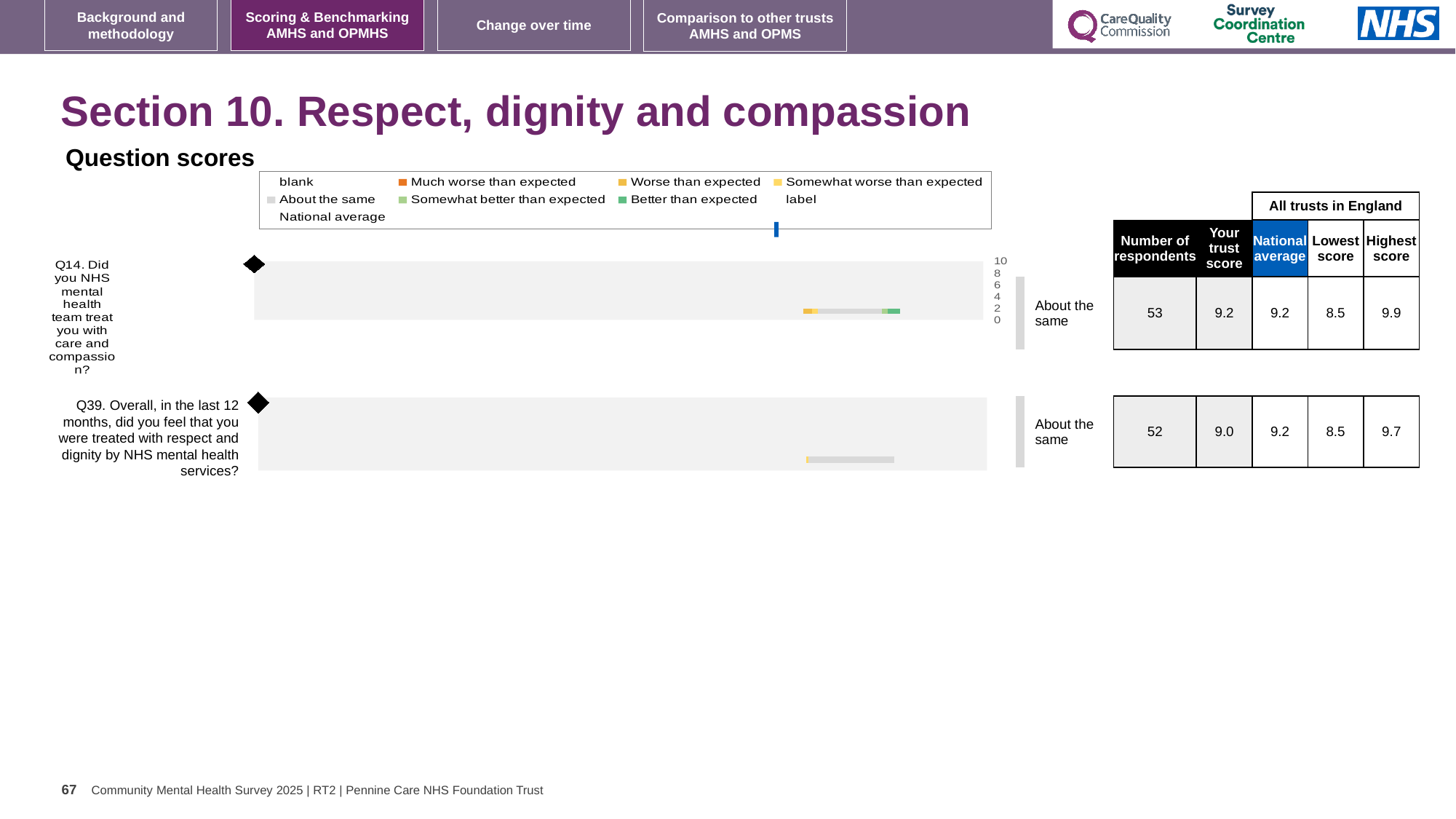
What is the number of respondents for Q39? 52 How many questions are plotted in the question scores chart? 2 By how much is the national average higher than the trust score for Q39? 0.2 Which question has the higher trust score, Q14 or Q39? Q14 What is the national average for Q39? 9.2 What is the highest score among all trusts in England for Q39? 9.7 What benchmark category is shown next to the bar for Q14? About the same What is the difference between the highest score and the lowest score for Q14? 1.4 What is the number of respondents for Q14 (care and compassion)? 53 What is the trust's score for Q39 (respect and dignity)? 9.0 What kind of chart is used to show the question scores on this slide? bar chart What is the trust's score for Q14 (care and compassion)? 9.2